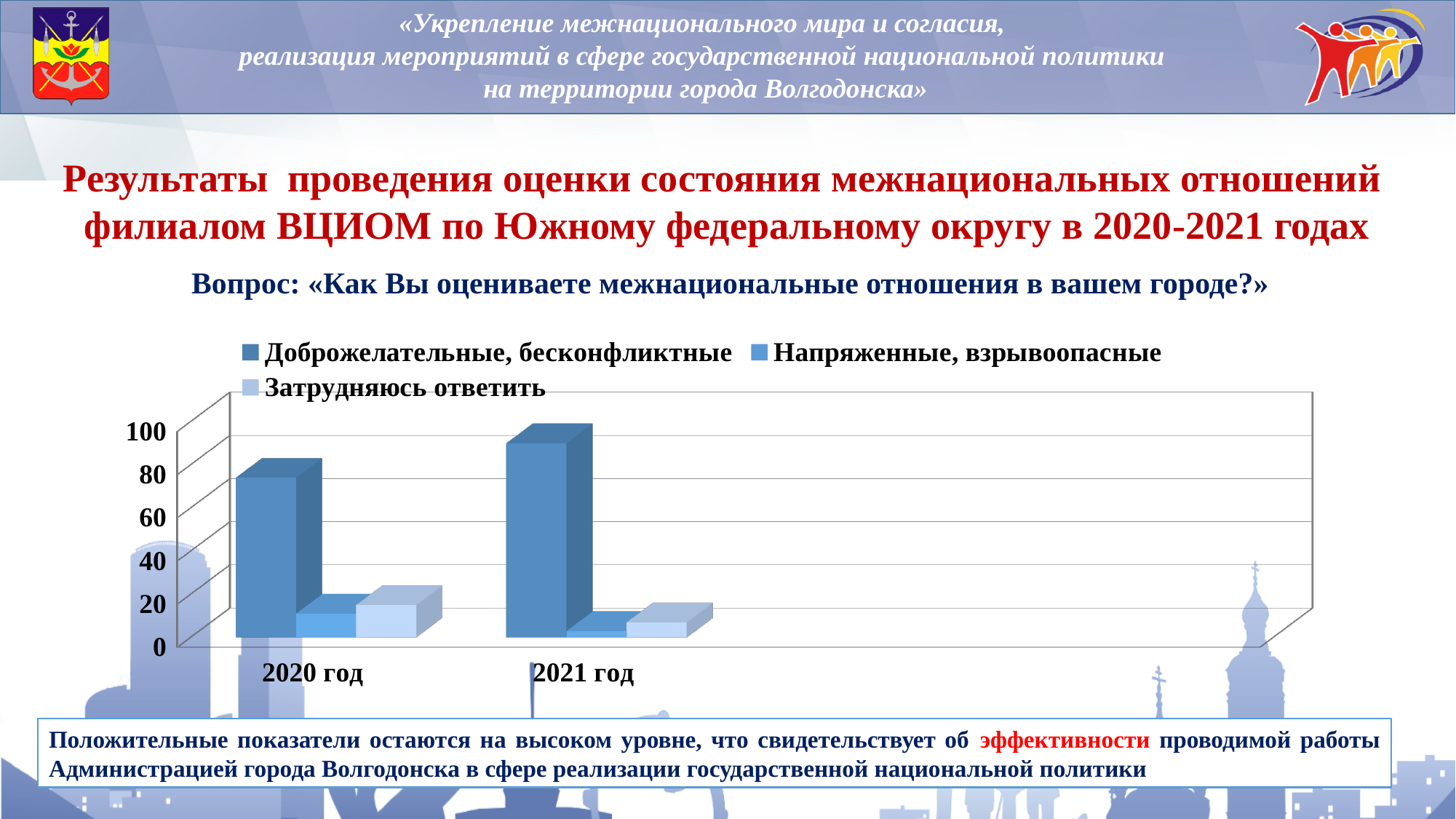
Which series has the lowest value for 2021 год? Напряженные, взрывоопасные Is the value for Доброжелательные, бесконфликтные in 2020 год greater or less than 60? greater How many year categories are shown on the x axis of the chart? 2 Which year has the larger value for Доброжелательные, бесконфликтные, 2020 год or 2021 год? 2021 год Which series has the highest value for 2021 год? Доброжелательные, бесконфликтные Is the value for Доброжелательные, бесконфликтные in 2021 год greater or less than 80? greater What is the first entry in the chart legend? Доброжелательные, бесконфликтные Is the value for Напряженные, взрывоопасные in 2021 год greater or less than 20? less Does the value for Напряженные, взрывоопасные rise or fall from 2020 год to 2021 год? fall What kind of chart is shown on the slide? bar chart How many series does the chart legend list? 3